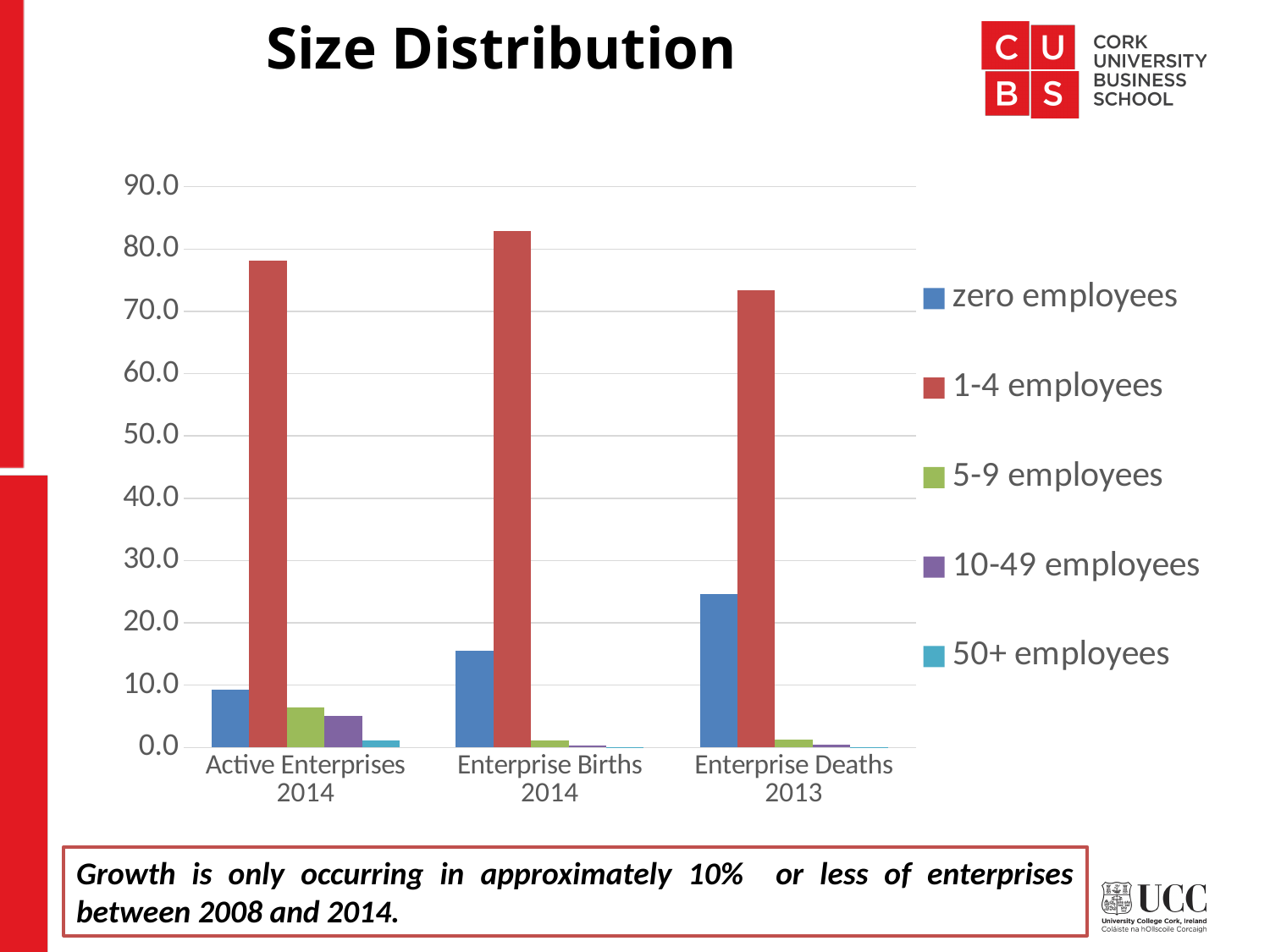
Which is larger: the 1-4 employees bar for Enterprise Births 2014 or for Enterprise Deaths 2013? Enterprise Births 2014 How many categories are shown on the x axis? 3 Is the value for zero employees in Enterprise Deaths 2013 greater or less than 20.0? greater Is the value for zero employees in Enterprise Births 2014 greater or less than 20.0? less How many series does the legend list? 5 In Active Enterprises 2014, which is larger: the bar for zero employees or the bar for 5-9 employees? zero employees Is the value for 1-4 employees in Active Enterprises 2014 greater or less than 70.0? greater What kind of chart is shown on the slide? bar chart What is the title of the slide containing the chart? Size Distribution Which category has the highest bar for 1-4 employees? Enterprise Births 2014 Which category has the lowest bar for 1-4 employees? Enterprise Deaths 2013 Which category has the highest bar for zero employees? Enterprise Deaths 2013